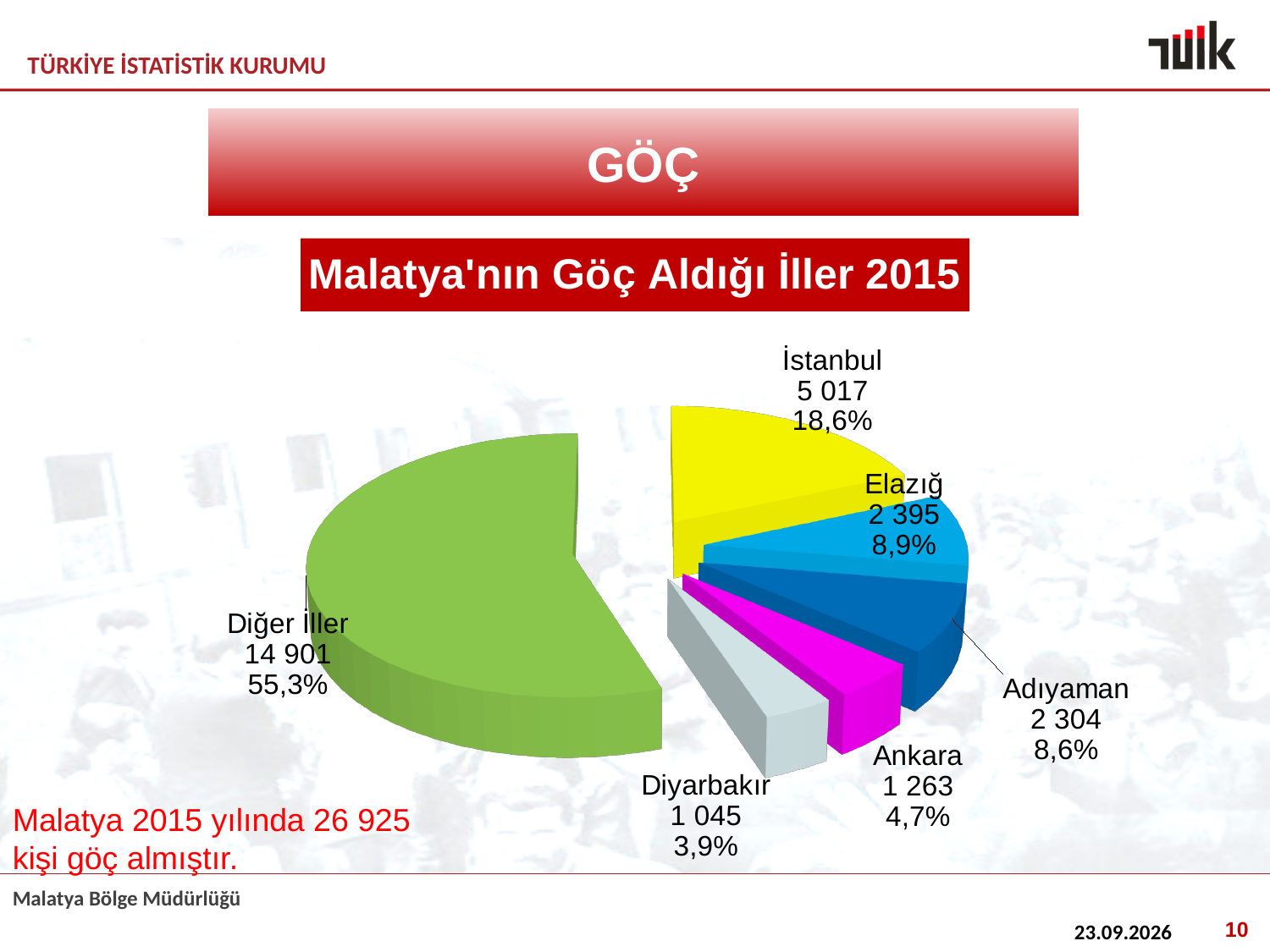
What is the title of the chart? Malatya'nın Göç Aldığı İller 2015 What share of the pie does Adıyaman represent? 8,6% What is the value shown for Elazığ? 2 395 What is the value shown for Diyarbakır? 1 045 Which is larger, the value for Ankara or the value for Diyarbakır? Ankara Which slice is the largest? Diğer İller What share of the pie does Diğer İller represent? 55,3% Which slice is the smallest? Diyarbakır What kind of chart is shown on the slide? pie chart What is the difference between the values for İstanbul and Elazığ? 2 622 How many slices does the pie chart have? 6 What is the value shown for İstanbul? 5 017